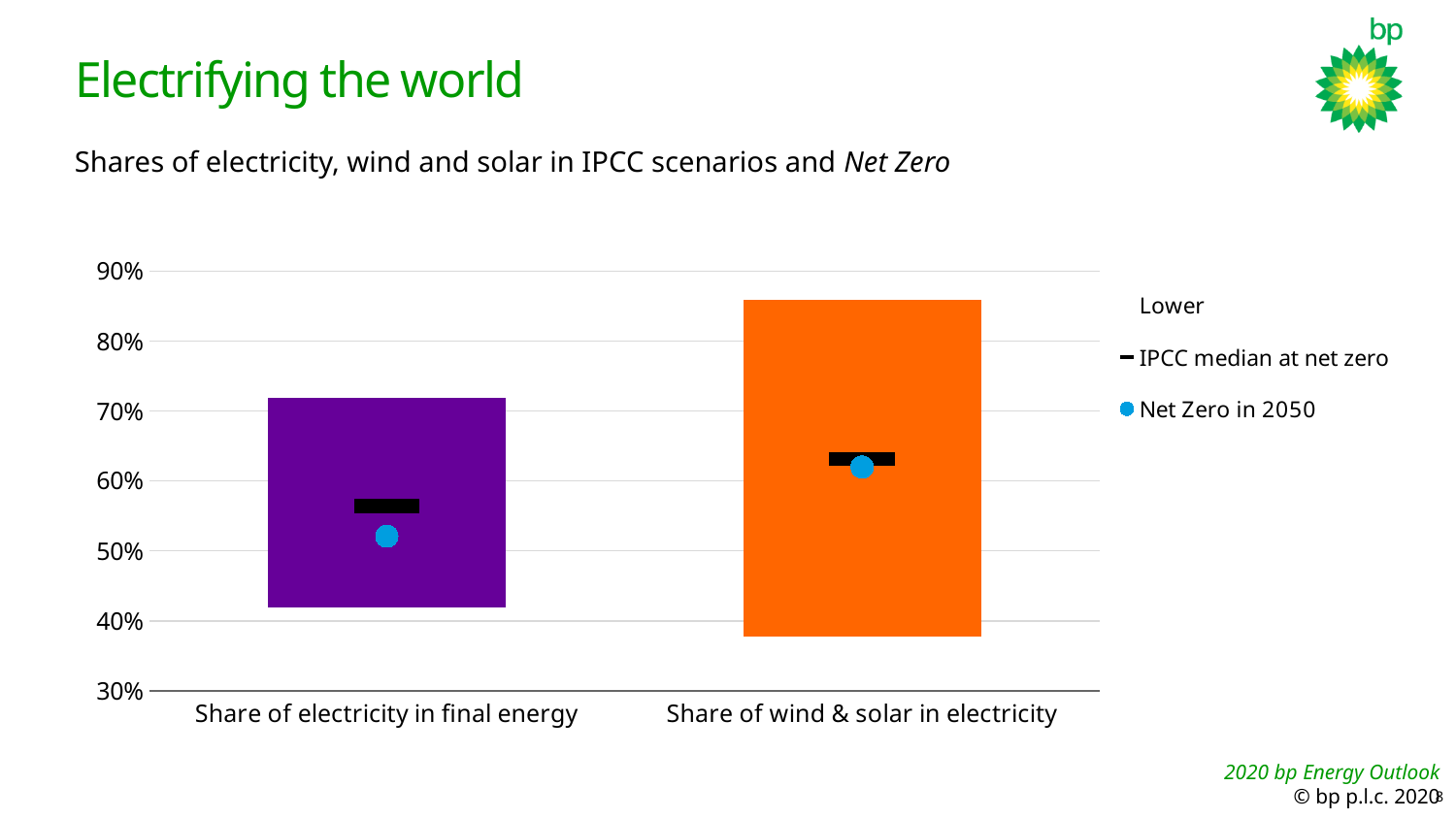
Is the Net Zero in 2050 value for Share of wind & solar in electricity greater or less than 60%? greater What kind of chart is shown on the slide? bar chart How many entries does the chart's legend list? 3 Which category has the higher IPCC median at net zero? Share of wind & solar in electricity Is the bottom of the range bar for Share of wind & solar in electricity greater or less than 40%? less Is the top of the range bar for Share of wind & solar in electricity greater or less than 80%? greater How many categories are shown on the x axis of the chart? 2 What colour is the range bar for Share of wind & solar in electricity? orange Which category has the higher Net Zero in 2050 value: Share of electricity in final energy or Share of wind & solar in electricity? Share of wind & solar in electricity